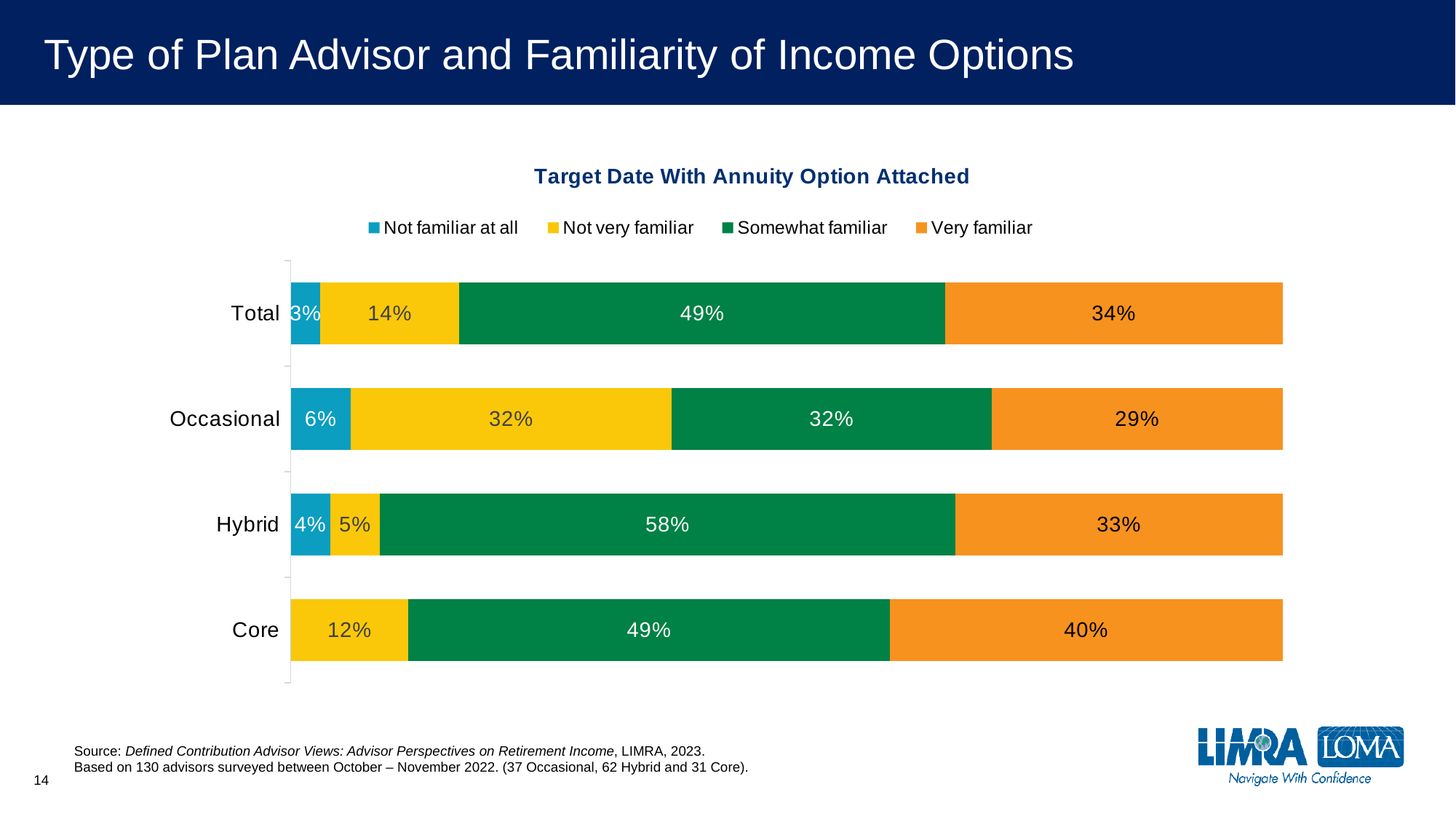
What percentage of Occasional advisors are Not familiar at all? 6% What is the difference between the Very familiar percentages for Core and Occasional advisors? 11% What percentage of Hybrid advisors are Somewhat familiar with the Target Date With Annuity Option Attached? 58% Which is larger: the Not very familiar value for Occasional or for Hybrid? Occasional What is the title of the chart? Target Date With Annuity Option Attached What kind of chart is shown on the slide? Stacked bar chart How many series does the legend list? 4 Which advisor category has the lowest Very familiar percentage? Occasional Which advisor category has the highest Somewhat familiar percentage? Hybrid What percentage of Core advisors are Very familiar? 40% How many advisor categories are shown on the chart? 4 What is the Not very familiar value for the Total category? 14%